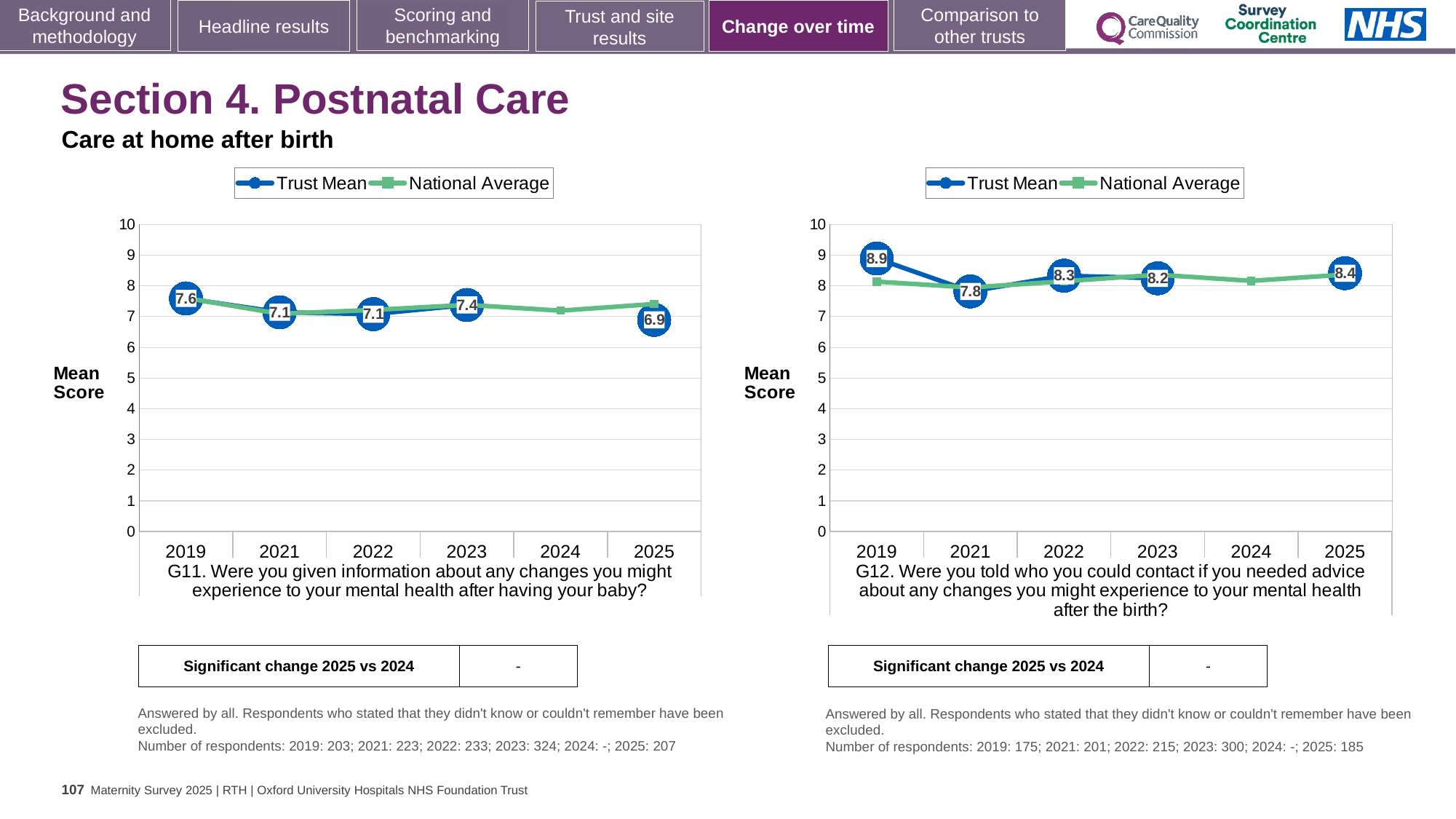
What kind of chart is the G12 chart? Line chart How many series does the legend of the G11 chart list? 2 In the G11 chart, what is the Trust Mean score for 2019? 7.6 In the G12 chart, which is larger, the Trust Mean score for 2022 or for 2023? 2022 In the G11 chart, which year has the highest Trust Mean score? 2019 In the G12 chart, is the Trust Mean score for 2025 greater or less than 8? greater In the G12 chart, what is the Trust Mean score for 2021? 7.8 In the G11 chart, which year has the lowest Trust Mean score? 2025 In the G11 chart, what is the Trust Mean score for 2025? 6.9 In the G12 chart, how many years are shown on the x axis? 6 In the G12 chart, which year has the highest Trust Mean score? 2019 In the G11 chart, what is the difference between the Trust Mean scores for 2019 and 2025? 0.7